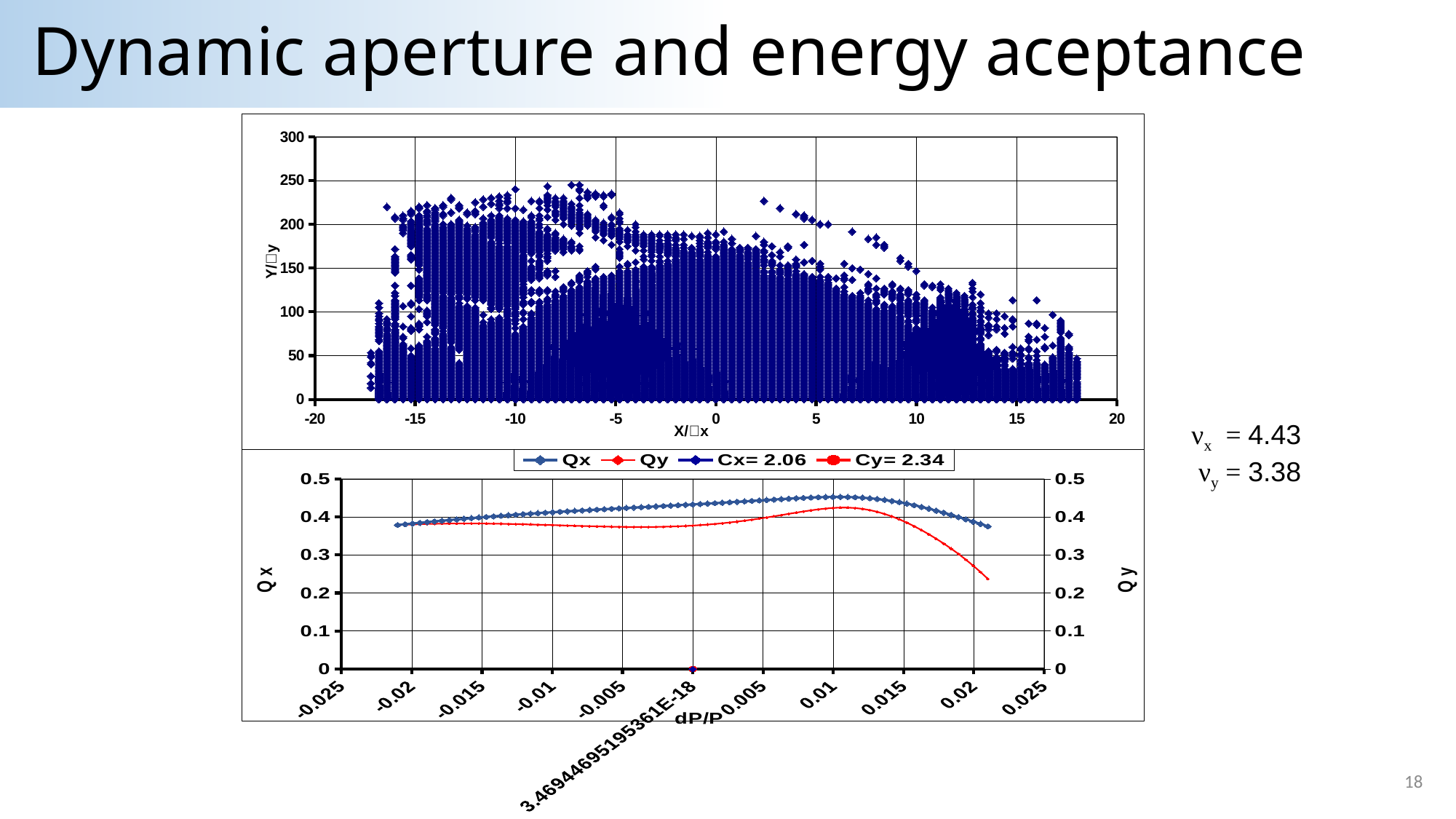
In the top chart, what is the label of the vertical axis? Y/□y In the bottom chart, at dP/P = 0.02, which series has the larger value, Qx or Qy? Qx In the bottom chart, is the Qy value at dP/P = 0.02 greater or less than 0.4? less In the bottom chart, what is the label of the horizontal axis? dP/P How many series does the legend of the bottom chart list? 4 In the top chart, is the highest Y/σy value reached by the plotted points greater or less than 200? greater In the bottom chart, does the Qy series rise or fall between dP/P = 0.01 and dP/P = 0.02? fall What kind of chart is the bottom chart on the slide? line chart What kind of chart is the top chart on the slide? scatter chart In the bottom chart, is the Qx value at dP/P = -0.02 greater or less than 0.4? less